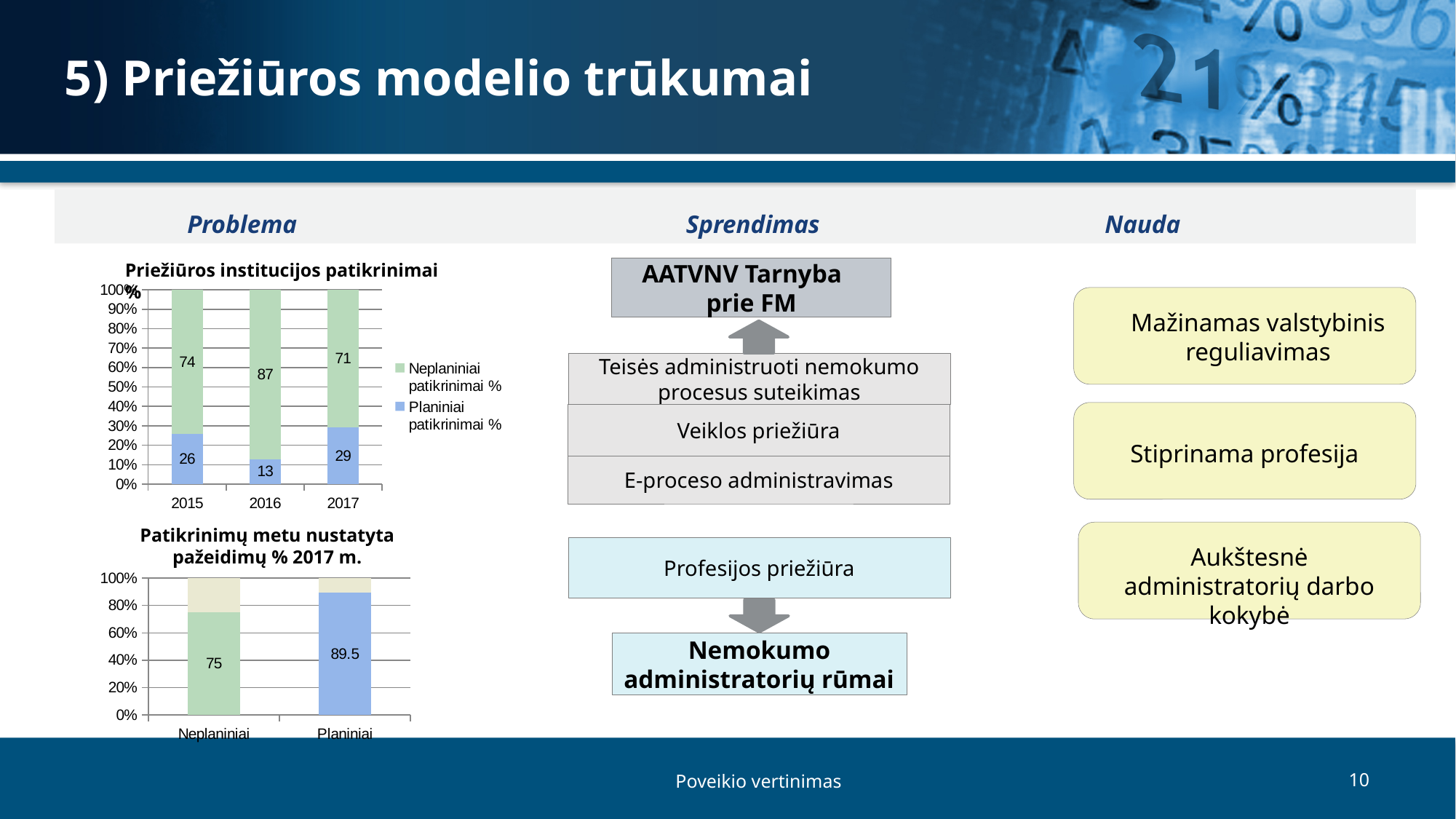
In the chart titled "Patikrinimų metu nustatyta pažeidimų % 2017 m.", what is the value for Planiniai? 89.5 In the chart titled "Priežiūros institucijos patikrinimai", which year has the highest Neplaniniai patikrinimai % value? 2016 In the chart titled "Patikrinimų metu nustatyta pažeidimų % 2017 m.", what is the difference between the labelled values for Planiniai and Neplaniniai? 14.5 In the chart titled "Priežiūros institucijos patikrinimai", how many series does the legend list? 2 In the chart titled "Priežiūros institucijos patikrinimai", what is the difference between the Planiniai patikrinimai % values for 2017 and 2015? 3 In the chart titled "Priežiūros institucijos patikrinimai", what is the value of Neplaniniai patikrinimai % for 2016? 87 In the chart titled "Priežiūros institucijos patikrinimai", what is the total of the stacked bar for 2015? 100 In the chart titled "Priežiūros institucijos patikrinimai", which year has the lowest Planiniai patikrinimai % value? 2016 In the chart titled "Priežiūros institucijos patikrinimai", what is the value of Planiniai patikrinimai % for 2017? 29 In the chart titled "Priežiūros institucijos patikrinimai", how many years are shown on the x axis? 3 In the chart titled "Patikrinimų metu nustatyta pažeidimų % 2017 m.", which category has the larger labelled value, Neplaniniai or Planiniai? Planiniai What kind of chart is the one titled "Patikrinimų metu nustatyta pažeidimų % 2017 m."? Bar chart